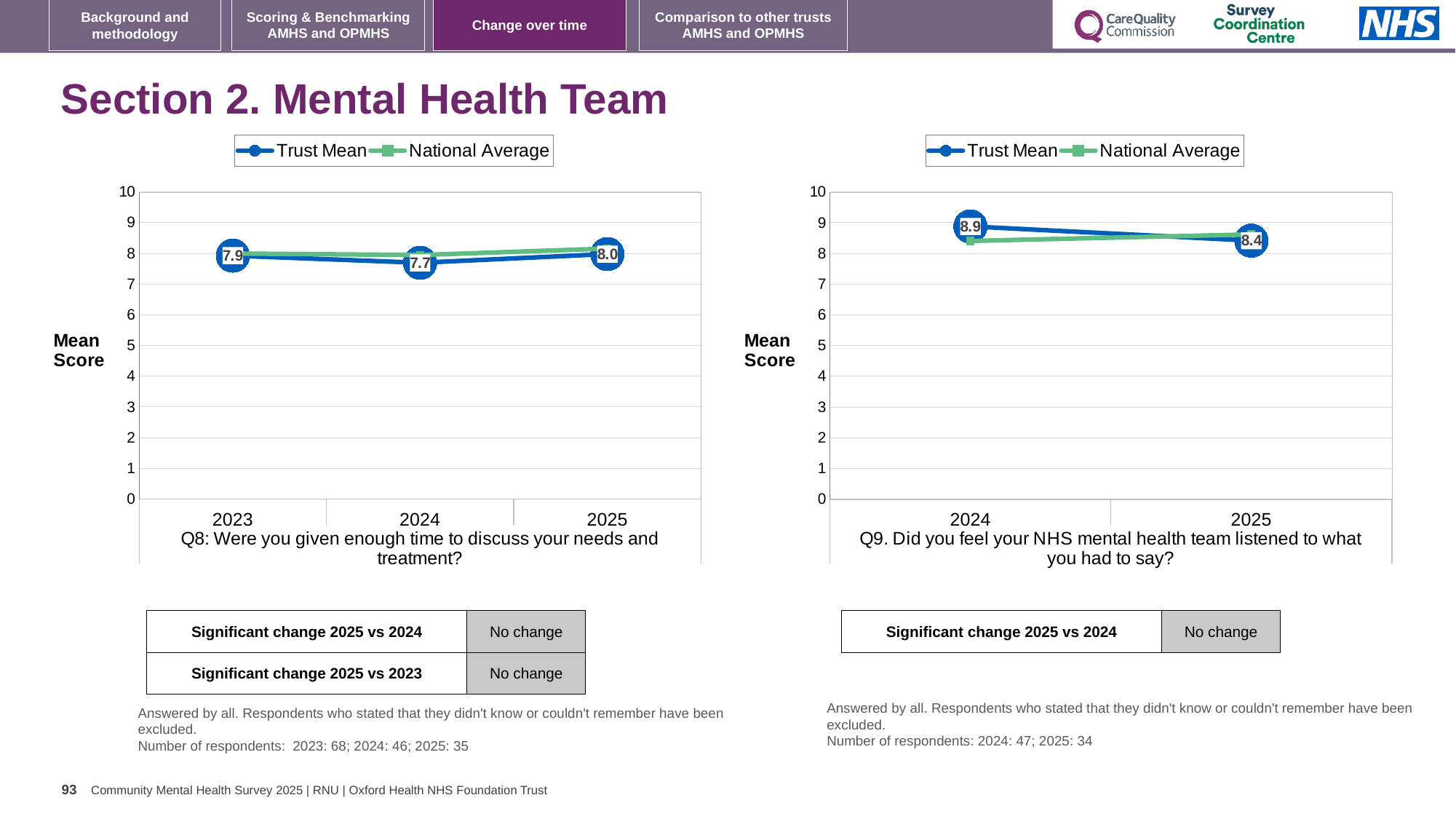
On the Q8 chart (left), which year has the lowest Trust Mean? 2024 On the Q8 chart (left), what is the Trust Mean for 2023? 7.9 How many years are shown on the x axis of the Q8 chart (left)? 3 On the Q9 chart (right), what is the Trust Mean for 2024? 8.9 What type of chart is the Q8 chart (left)? line chart How many series does the legend of the Q9 chart (right) list? 2 On the Q8 chart (left), which year has the highest Trust Mean? 2025 On the Q9 chart (right), what is the difference between the Trust Mean for 2024 and 2025? 0.5 On the Q8 chart (left), what is the Trust Mean for 2024? 7.7 On the Q9 chart (right), does the Trust Mean rise or fall from 2024 to 2025? fall On the Q8 chart (left), what is the Trust Mean for 2025? 8.0 On the Q9 chart (right), what is the Trust Mean for 2025? 8.4